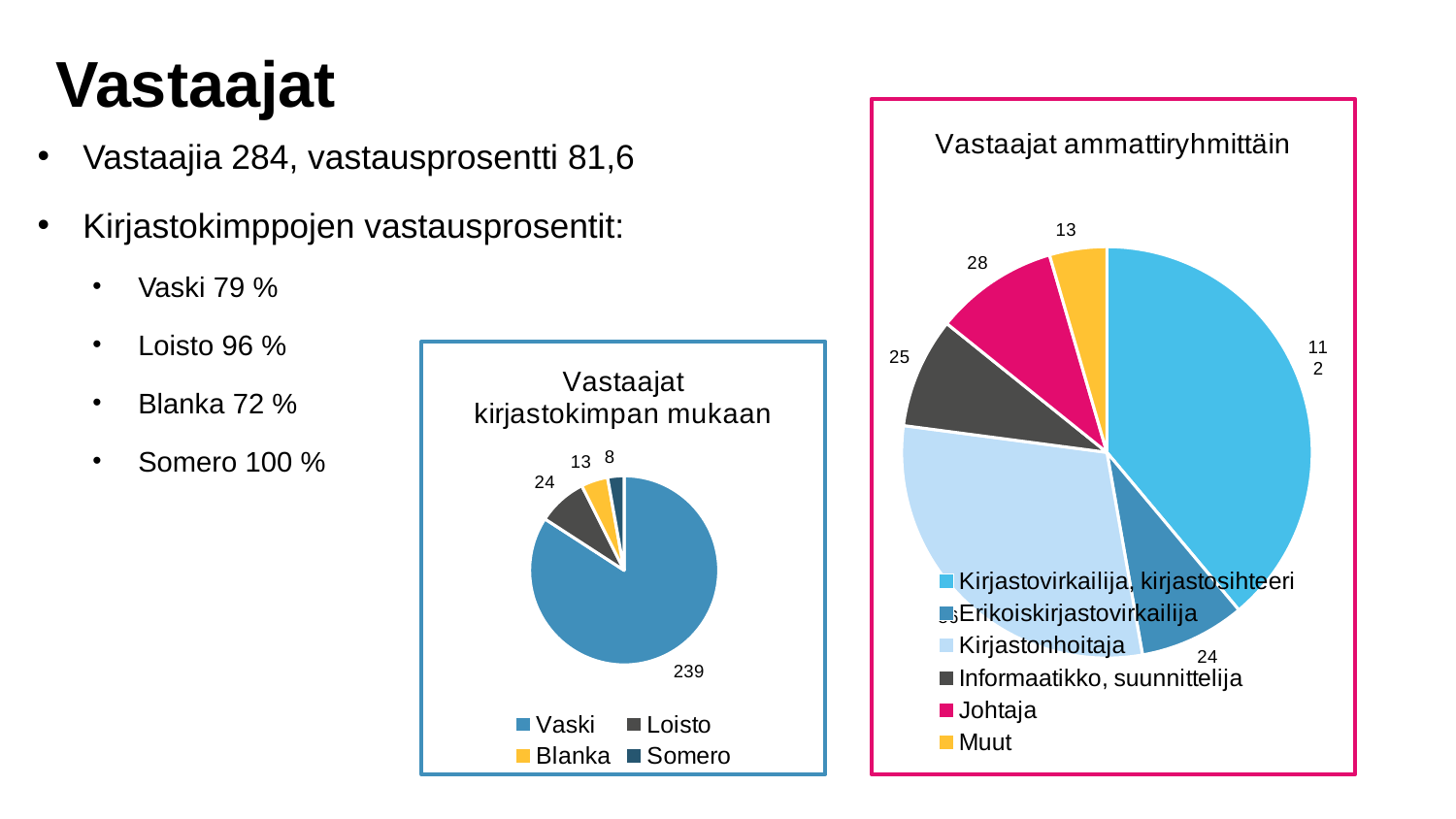
In the chart titled 'Vastaajat ammattiryhmittäin', what is the value for Muut? 13 In the chart titled 'Vastaajat ammattiryhmittäin', which category has the largest slice? Kirjastovirkailija, kirjastosihteeri In the chart titled 'Vastaajat ammattiryhmittäin', what is the difference between the values for Johtaja and Informaatikko, suunnittelija? 3 What kind of chart is 'Vastaajat kirjastokimpan mukaan'? Pie chart In the chart titled 'Vastaajat kirjastokimpan mukaan', how many categories does the legend list? 4 In the chart titled 'Vastaajat ammattiryhmittäin', which is larger: Johtaja or Muut? Johtaja In the chart titled 'Vastaajat kirjastokimpan mukaan', what is the value for Vaski? 239 In the chart titled 'Vastaajat kirjastokimpan mukaan', what is the value for Loisto? 24 In the chart titled 'Vastaajat ammattiryhmittäin', how many categories does the legend list? 6 In the chart titled 'Vastaajat kirjastokimpan mukaan', which category has the smallest slice? Somero In the chart titled 'Vastaajat ammattiryhmittäin', what is the value for Johtaja? 28 In the chart titled 'Vastaajat kirjastokimpan mukaan', what is the difference between the values for Loisto and Blanka? 11